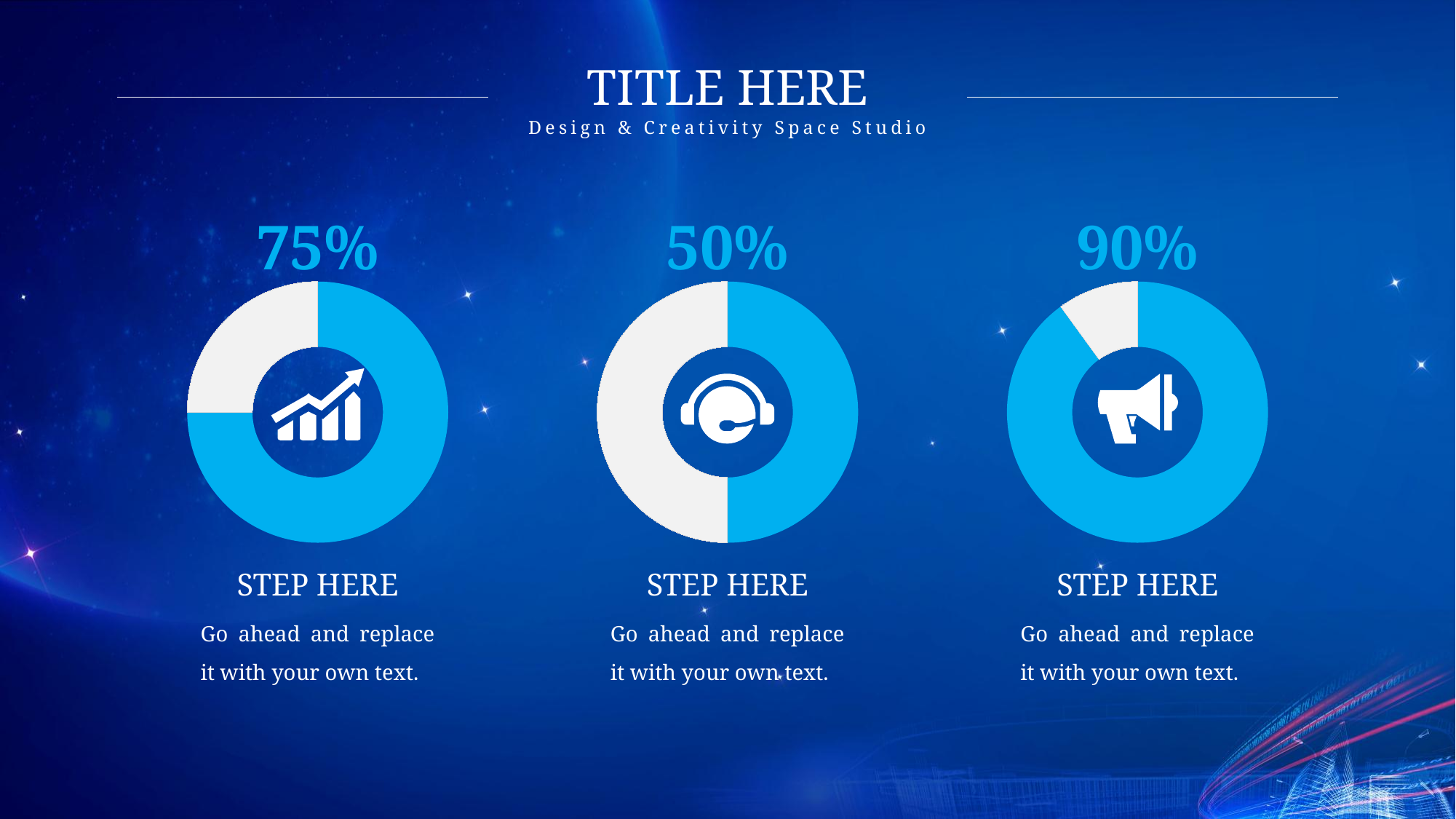
Is the percentage on the left donut chart larger or smaller than the percentage on the middle donut chart? Larger Which of the three donut charts shows the highest percentage? The right chart (90%) What is the difference between the percentage on the right donut chart and the percentage on the left donut chart? 15% What share of the middle donut chart is filled in blue? 50% How many donut charts are shown on the slide? 3 What is the difference between the percentage on the left donut chart and the percentage on the middle donut chart? 25% What percentage is shown above the right donut chart? 90% What is the title of the slide containing the three donut charts? TITLE HERE What percentage is shown above the middle donut chart? 50% What percentage is shown above the left donut chart? 75% What kind of chart is used to display the percentages on the slide? Donut chart Which of the three donut charts shows the lowest percentage? The middle chart (50%)